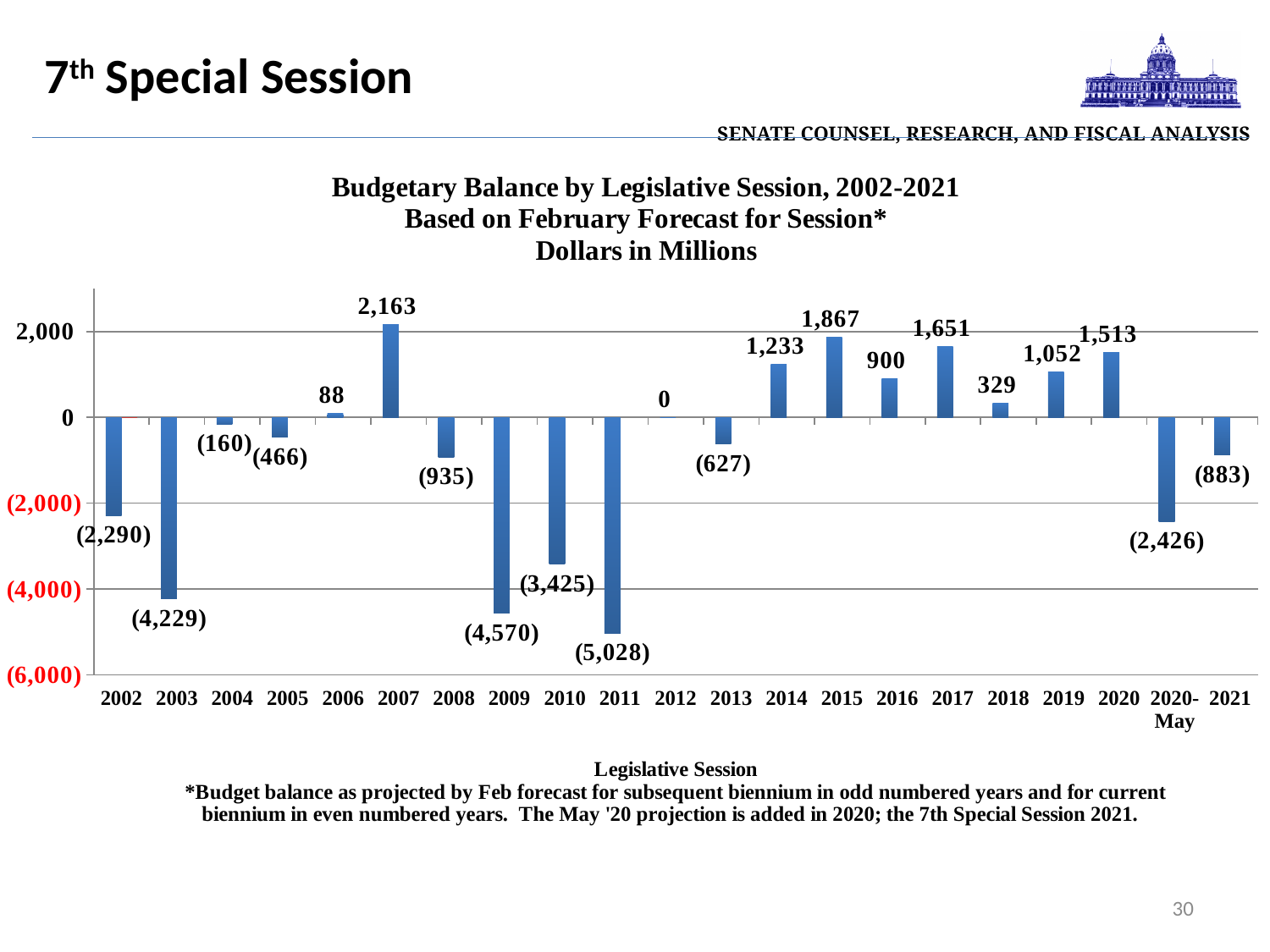
Which legislative session has the lowest budgetary balance? 2011 How many bars (legislative sessions) are plotted on the chart? 21 What is the budgetary balance shown for the 2007 legislative session? 2,163 What value is labeled for the 2012 session? 0 Which legislative session has the highest budgetary balance? 2007 Which is larger, the value for 2017 or the value for 2019? 2017 What is the difference between the 2015 value (1,867) and the 2014 value (1,233)? 634 What kind of chart is shown on the slide? Bar chart What is the label of the x axis? Legislative Session What value is labeled for the 2011 session? (5,028) What is the title of the chart? Budgetary Balance by Legislative Session, 2002-2021 Based on February Forecast for Session* Dollars in Millions What is the value shown for the 2020-May bar? (2,426)